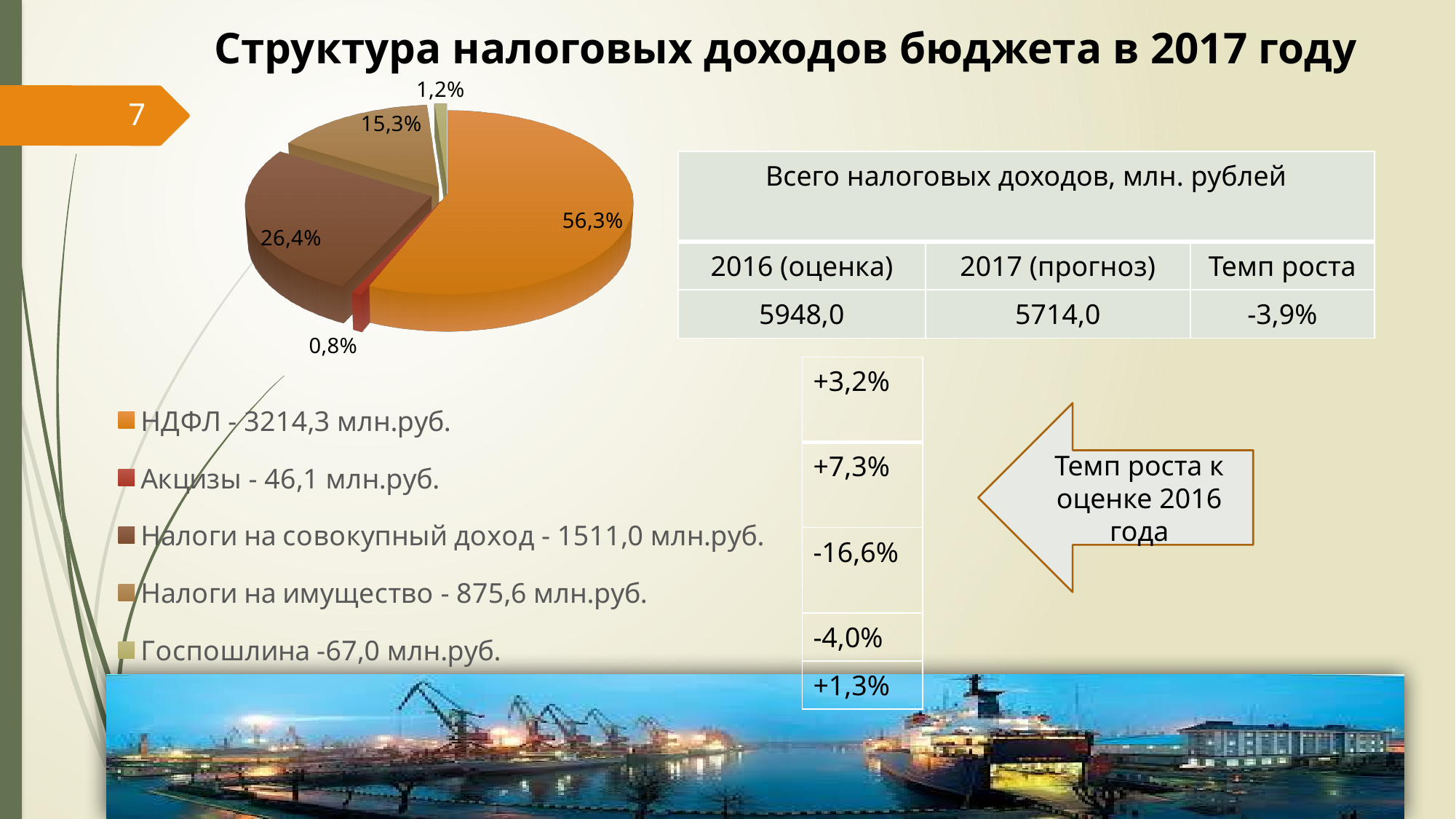
Which category has the largest slice in the pie chart? НДФЛ What share of the pie chart does Налоги на имущество account for? 15,3% Which category has the smallest slice in the pie chart? Акцизы What share of the pie chart does Акцизы account for? 0,8% What share of the pie chart does Госпошлина account for? 1,2% Which slice is larger: Налоги на совокупный доход or Налоги на имущество? Налоги на совокупный доход What is the difference in percentage points between the НДФЛ slice and the Налоги на совокупный доход slice? 29,9 According to the legend, what amount in млн.руб. corresponds to Налоги на имущество? 875,6 млн.руб. How many slices does the pie chart have? 5 What type of chart is shown on the slide? Pie chart